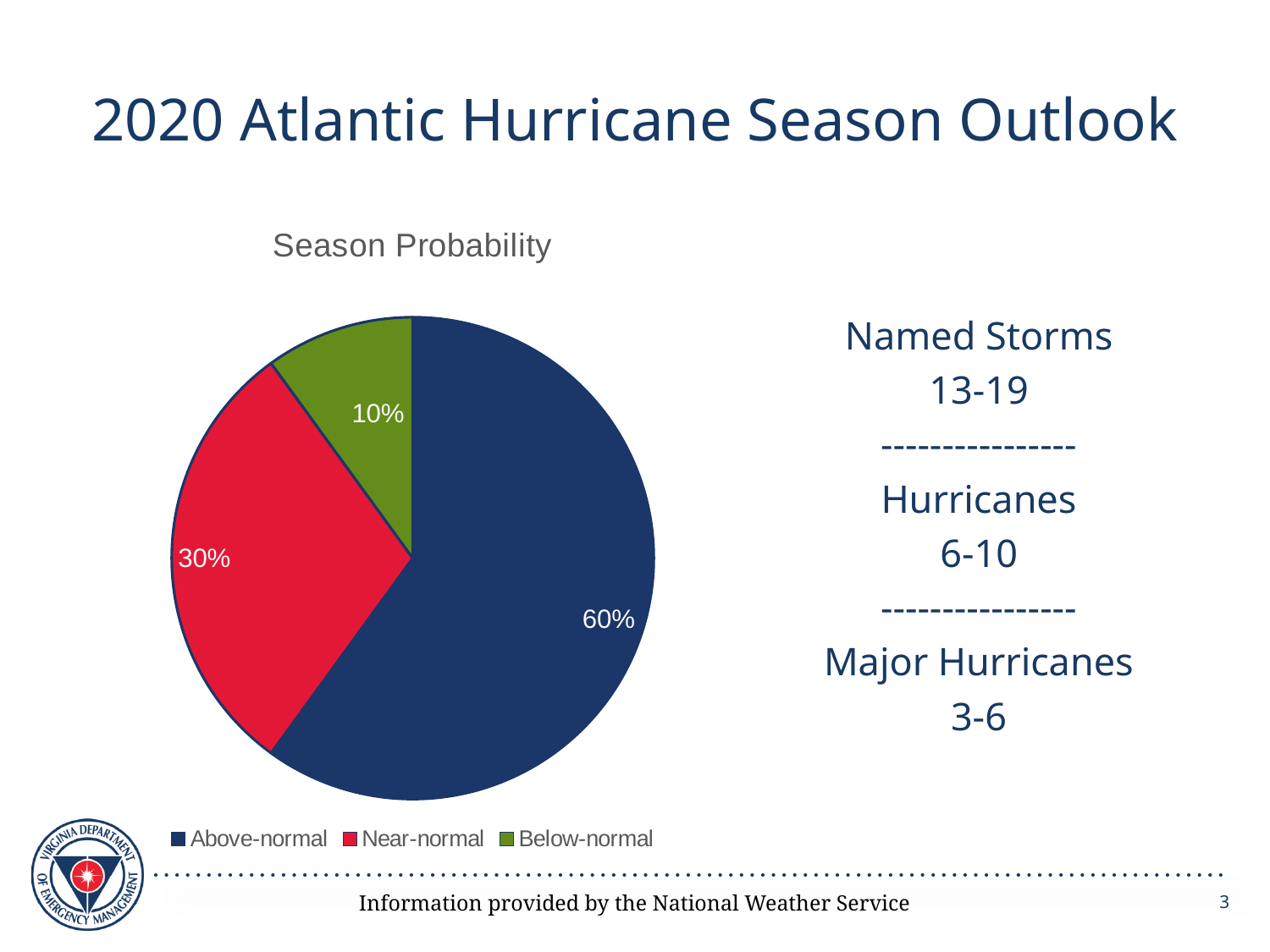
How many entries does the legend list? 3 What is the value for Above-normal? 60% How many categories does the pie chart have? 3 What is the value for Below-normal? 10% What is the value for Near-normal? 30% What kind of chart is shown on the slide? pie chart Which category has the largest share of the pie? Above-normal Which is larger, Near-normal or Below-normal? Near-normal What colour is the Near-normal slice? red Which category has the smallest share of the pie? Below-normal What is the title of the chart? Season Probability What is the difference between the Above-normal and Near-normal values? 30%